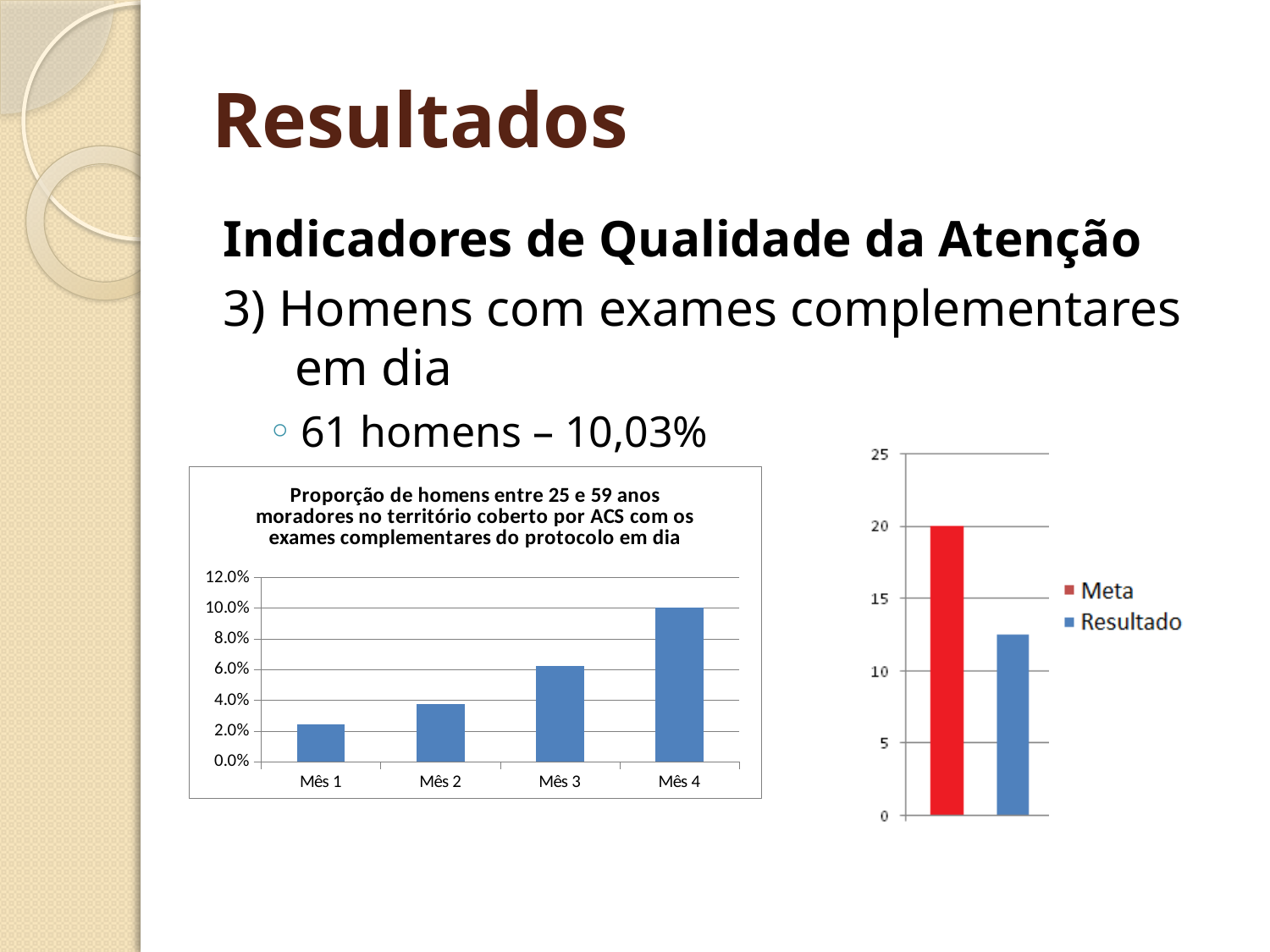
In the left chart, which month has the lowest value? Mês 1 In the left chart, is the value for Mês 3 greater or less than 4.0%? greater In the right chart, what colour is the Meta bar? red In the right chart, what is the value of Meta? 20 In the right chart, is the value for Resultado greater or less than 15? less In the left chart, is the value for Mês 1 greater or less than 4.0%? less In the left chart, what kind of chart is shown? bar chart In the left chart, which is larger, the value for Mês 2 or the value for Mês 3? Mês 3 In the left chart, which month has the highest value? Mês 4 In the right chart, how many series does the legend list? 2 In the left chart, do the values rise or fall from Mês 1 to Mês 4? rise In the left chart, how many months are plotted on the x axis? 4